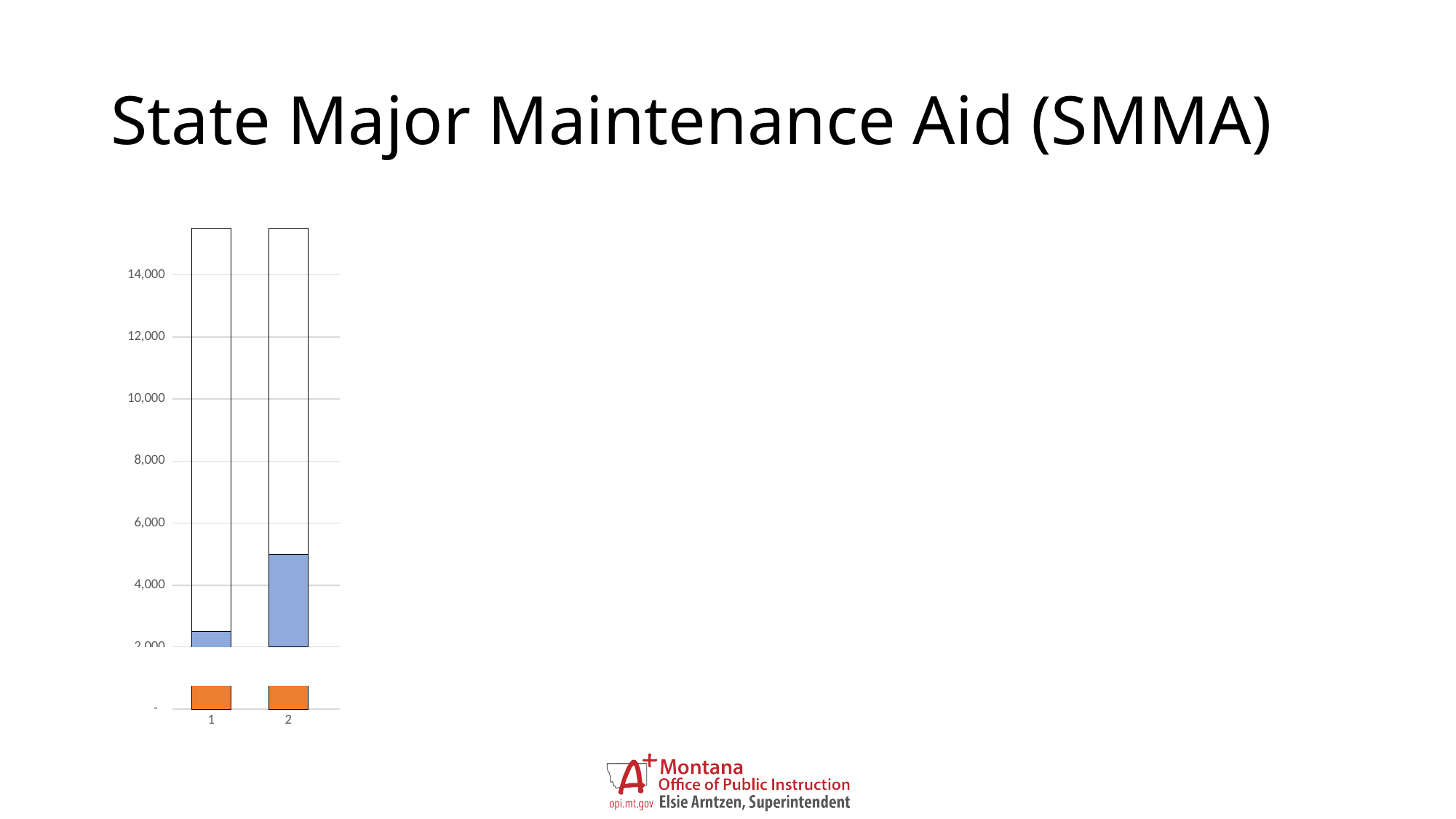
Does the blue segment rise or fall from category 1 to category 2? rise What is the highest value labelled on the vertical axis of the chart? 14,000 Is the top of the blue segment for category 2 greater or less than 4,000? greater What kind of chart is shown on the slide? Stacked bar chart Is the total height of the bar for category 1 greater or less than 14,000? greater How many categories are shown on the x axis of the chart? 2 What are the category labels on the x axis of the chart? 1 and 2 Is the top of the blue segment for category 2 greater or less than 6,000? less Which category has the larger blue segment, 1 or 2? 2